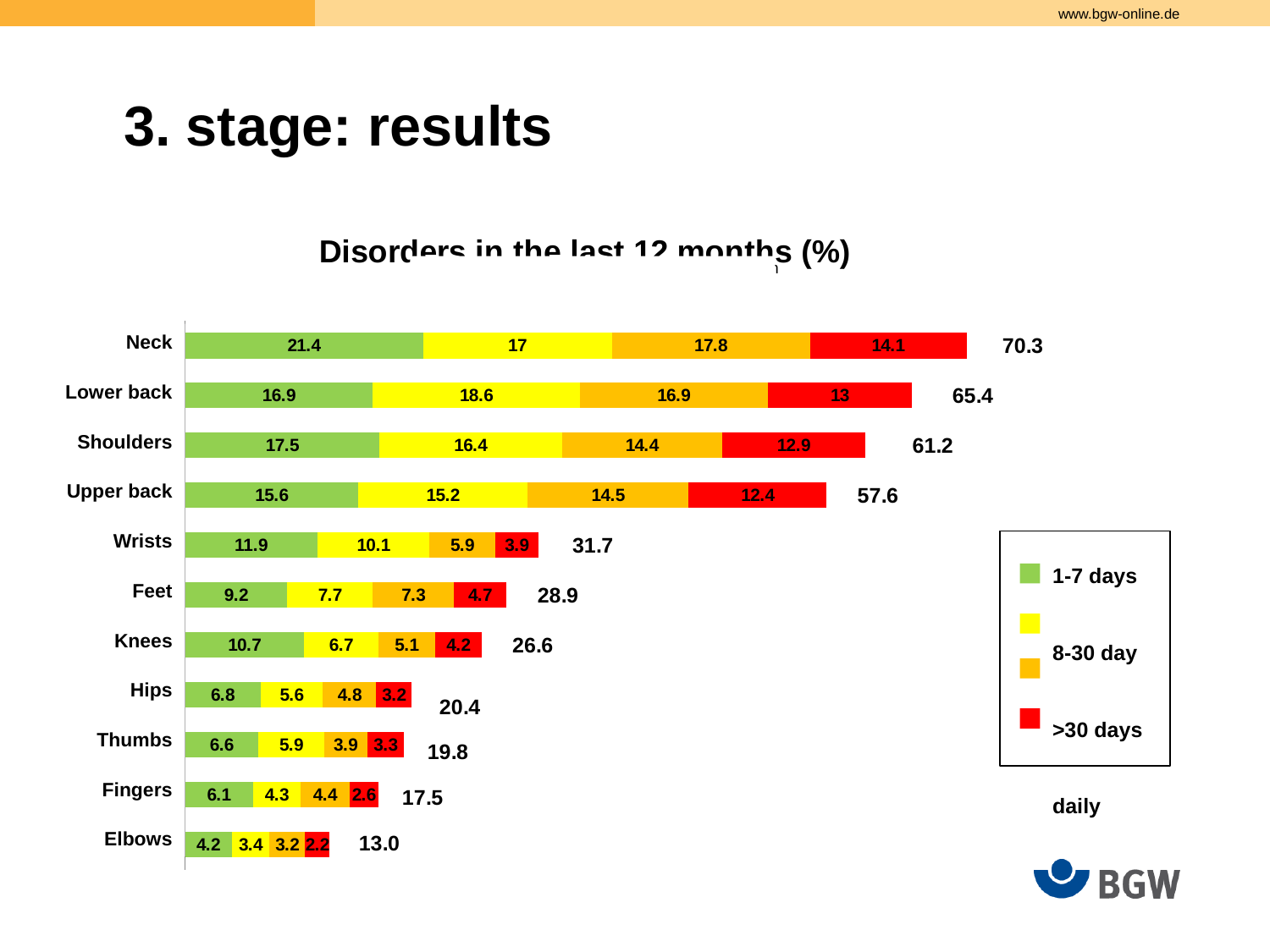
How many body regions are shown in the chart? 11 Which is larger, the 1-7 days value for Knees or the 1-7 days value for Feet? Knees What is the title of the chart? Disorders in the last 12 months (%) What is the difference between the total for Neck and the total for Lower back? 4.9 Which body region has the highest total value? Neck How many series does the legend list? 4 Which body region has the lowest total value? Elbows What kind of chart is shown on the slide? Stacked bar chart What is the 1-7 days value for Lower back? 16.9 What is the total value shown for Neck? 70.3